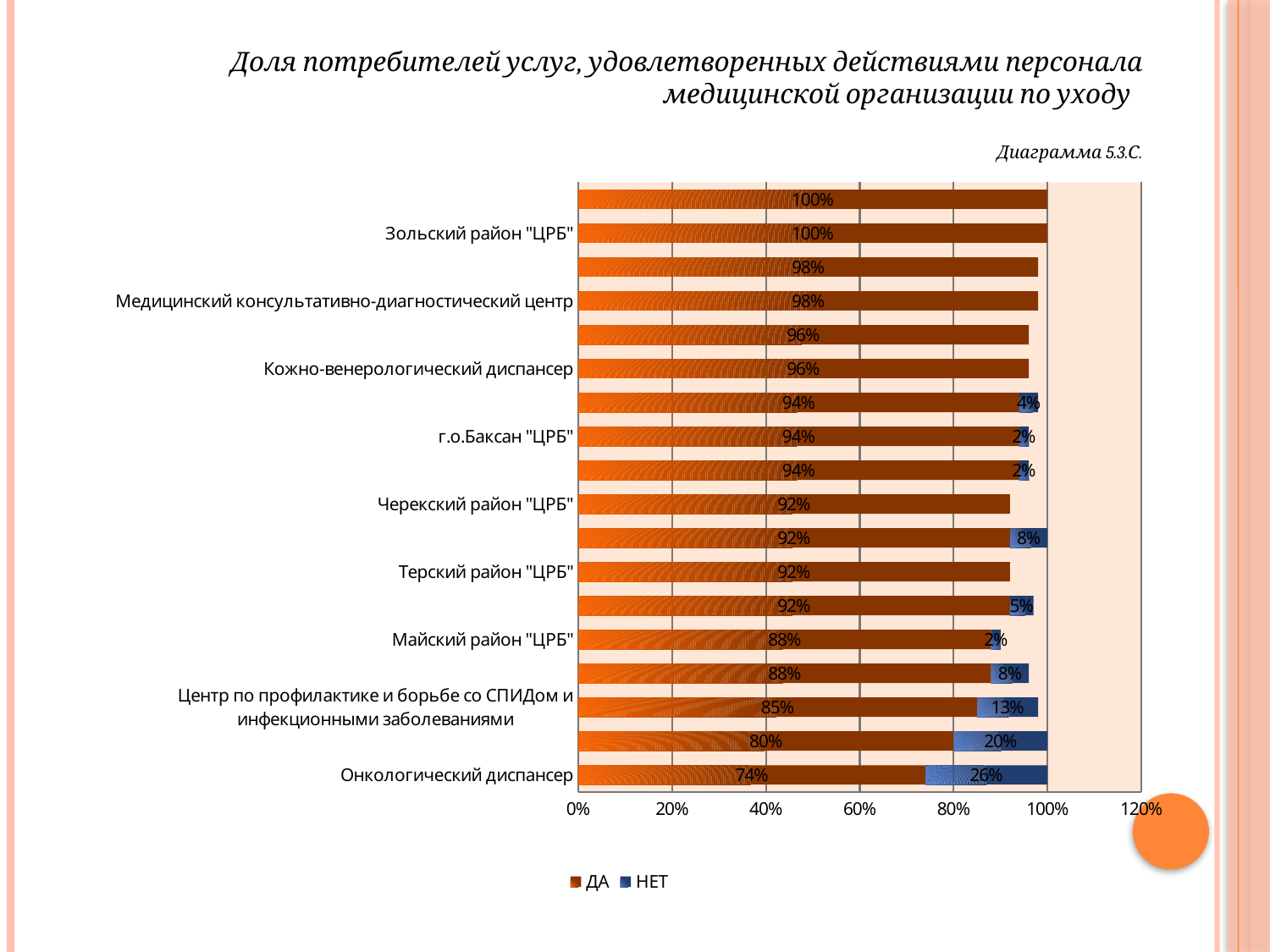
What kind of chart is shown on the slide? Bar chart What is the НЕТ value for Онкологический диспансер? 26% What is the ДА value for Майский район "ЦРБ"? 88% What is the ДА value for Зольский район "ЦРБ"? 100% What is the НЕТ value for Центр по профилактике и борьбе со СПИДом и инфекционными заболеваниями? 13% How many series does the legend list? 2 What is the total of the stacked bar for Онкологический диспансер (ДА plus НЕТ)? 100% Which labeled organization has the highest НЕТ value? Онкологический диспансер Which has the larger ДА value: Майский район "ЦРБ" or Центр по профилактике и борьбе со СПИДом и инфекционными заболеваниями? Майский район "ЦРБ" Which labeled organization has the lowest ДА value? Онкологический диспансер What is the ДА value for Онкологический диспансер? 74% What is the difference between the ДА values for Зольский район "ЦРБ" and Онкологический диспансер? 26%